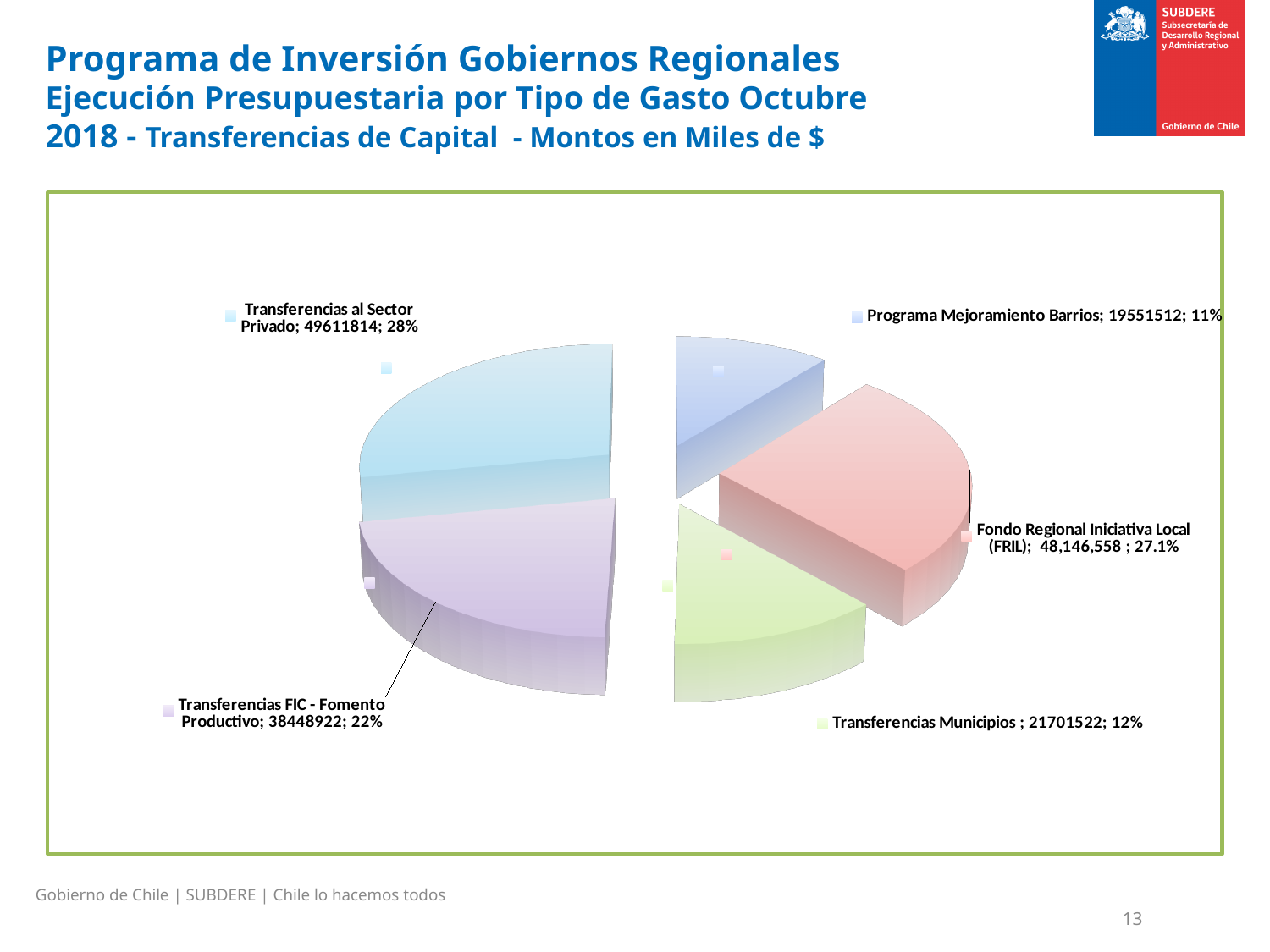
Which category has the smallest value in the pie chart? Programa Mejoramiento Barrios What is the value shown for Transferencias Municipios? 21701522 What percentage share does Transferencias FIC - Fomento Productivo have? 22% What is the difference between the values for Transferencias Municipios and Programa Mejoramiento Barrios? 2150010 What is the value shown for Fondo Regional Iniciativa Local (FRIL)? 48,146,558 What is the value shown for Transferencias al Sector Privado? 49611814 Which is larger, the value for Transferencias FIC - Fomento Productivo or the value for Transferencias Municipios? Transferencias FIC - Fomento Productivo What percentage share does Fondo Regional Iniciativa Local (FRIL) have? 27.1% How many slices does the pie chart have? 5 Which category has the largest value in the pie chart? Transferencias al Sector Privado What type of chart is shown on the slide? Pie chart What is the value shown for Programa Mejoramiento Barrios? 19551512